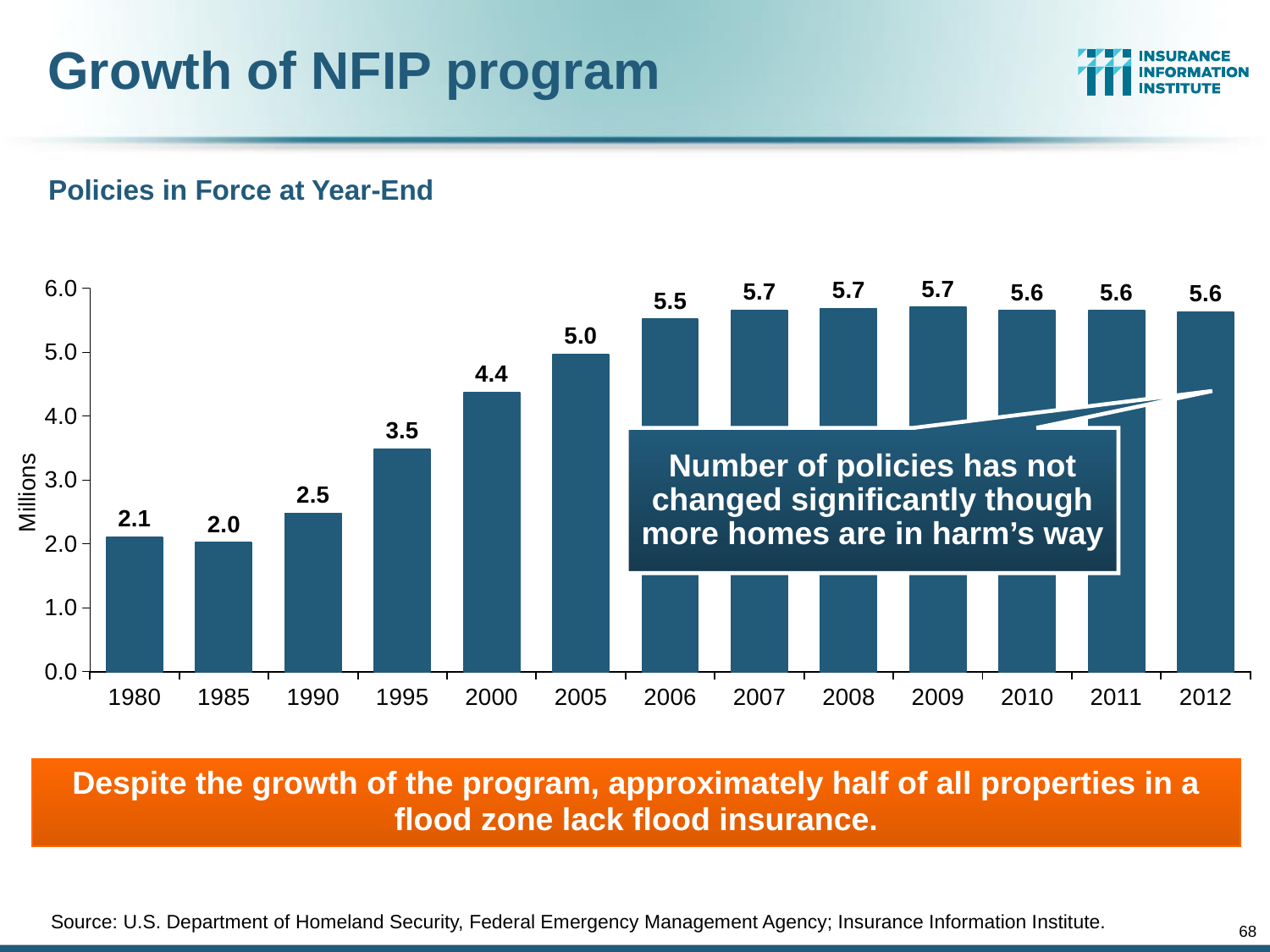
What is the difference between the values for 2005 and 1995? 1.5 What is the value for 2012? 5.6 What is the value for 2000? 4.4 Is the value for 2006 greater or less than 5.0? greater Which year has the lowest value? 1985 What is the value for 1980? 2.1 What is the label on the y axis? Millions Which is larger, the value for 1990 or the value for 1995? 1995 Do the values rise or fall from 1985 to 2007? rise What kind of chart is this? bar chart What is the difference between the values for 2012 and 1980? 3.5 How many years are shown on the x axis? 13